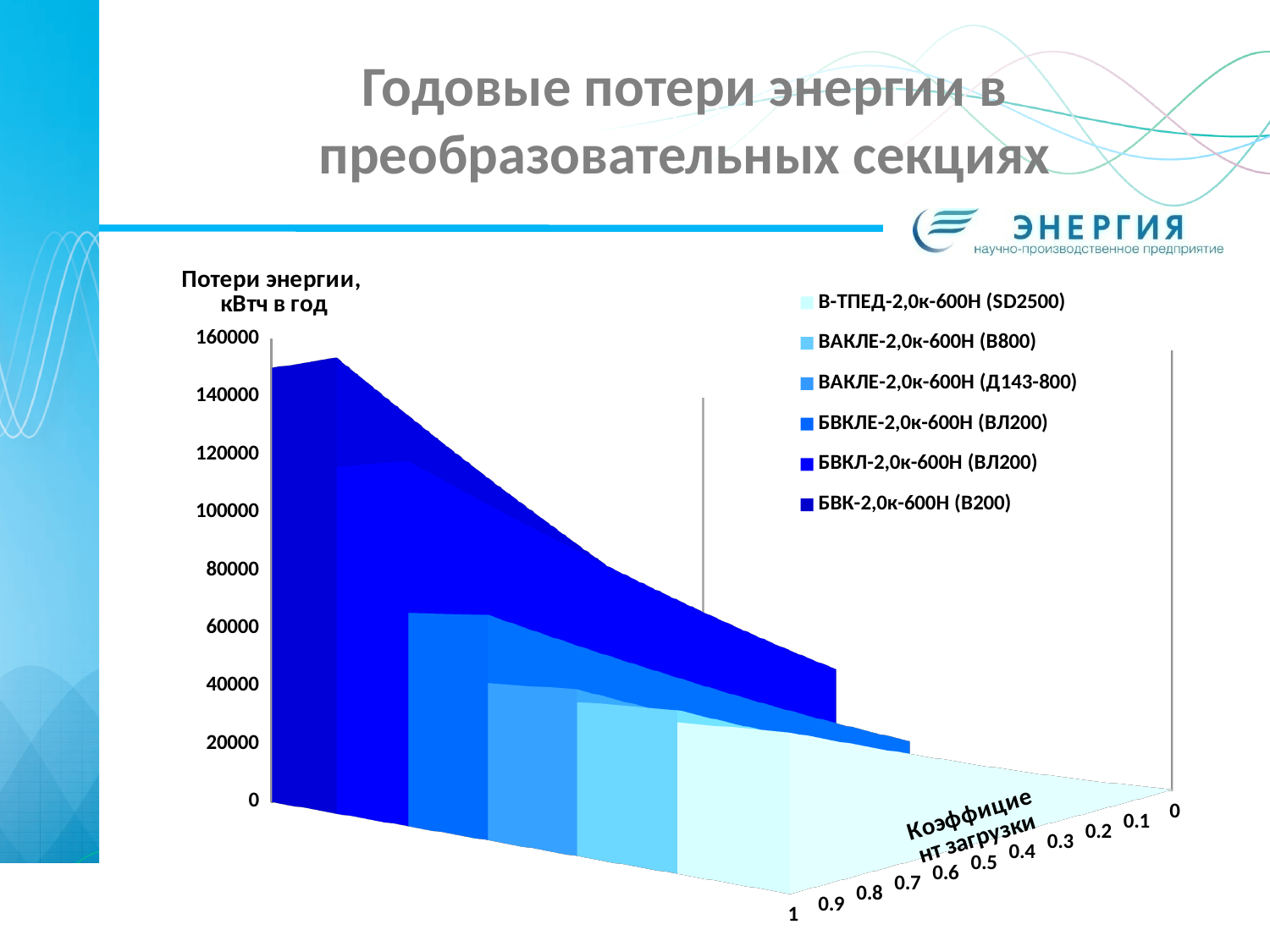
Is the value for БВК-2,0к-600Н (В200) at load factor 1 greater or less than 140000? greater How many load factor (Коэффициент загрузки) values are marked along the x axis? 11 Which series has the highest energy losses at load factor 1? БВК-2,0к-600Н (В200) What is the highest value marked on the vertical axis? 160000 Which series is listed last in the legend? БВК-2,0к-600Н (В200) Is the value for БВК-2,0к-600Н (В200) at load factor 0 greater or less than 20000? greater What is the title of the chart on the slide? Годовые потери энергии в преобразовательных секциях What kind of chart is shown on the slide? area chart Do the energy losses rise or fall as the load factor goes from 1 to 0 along the x axis? fall Which series is listed first in the legend? В-ТПЕД-2,0к-600Н (SD2500) How many series does the legend list? 6 What is the label of the vertical axis? Потери энергии, кВтч в год